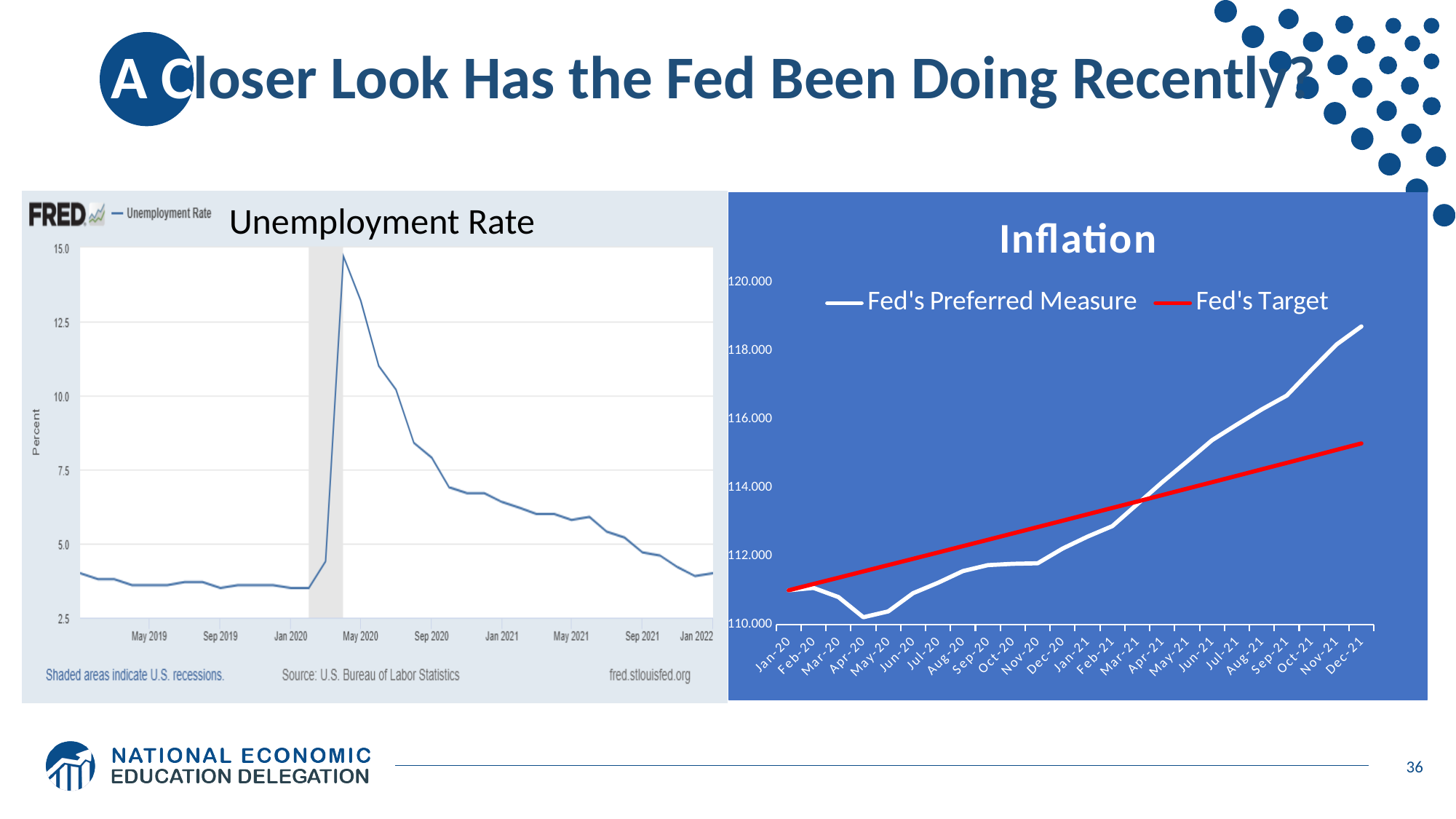
What kind of chart is the Inflation chart on the right? line chart In the Inflation chart, is the value of Fed's Preferred Measure at Apr-20 greater or less than 112.000? less In the Inflation chart, does the Fed's Target line rise or fall from Jan-20 to Dec-21? rise In the Unemployment Rate chart, is the peak value in 2020 greater or less than 12.5? greater What kind of chart is the Unemployment Rate chart on the left? line chart How many series does the legend of the Inflation chart list? 2 In the Inflation chart, is the value of Fed's Preferred Measure at Dec-21 greater or less than 118.000? greater In the Inflation chart, what colour is the Fed's Target line? red In the Inflation chart, which series is higher at Nov-20, Fed's Preferred Measure or Fed's Target? Fed's Target In the Inflation chart, which series is higher at Dec-21, Fed's Preferred Measure or Fed's Target? Fed's Preferred Measure In the Unemployment Rate chart, does the unemployment rate rise or fall from May 2020 to Jan 2022? fall How many months are shown on the x axis of the Inflation chart? 24